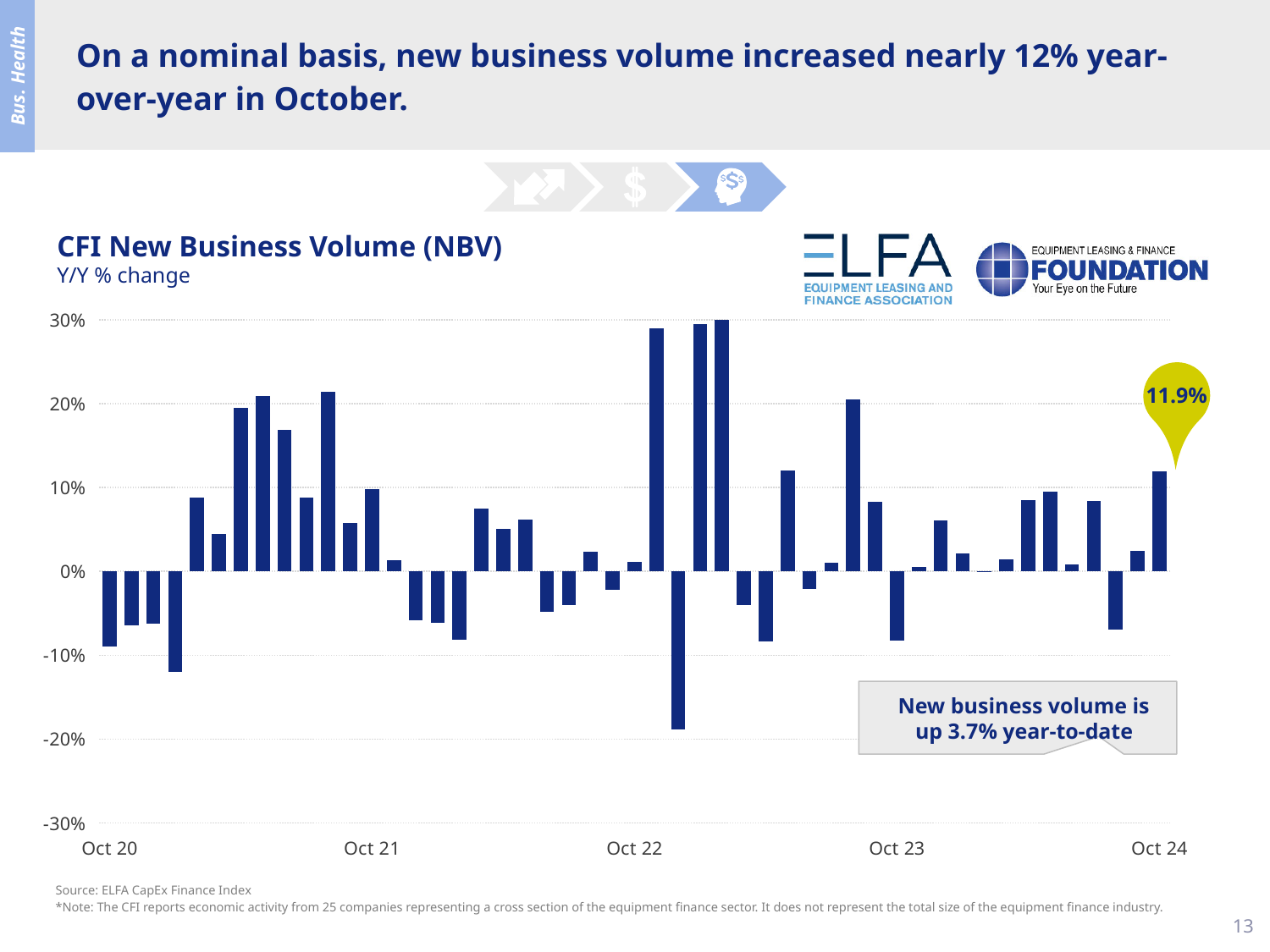
Is the highest value on the chart greater or less than 20%? greater How many labels are shown on the x axis of the chart? 5 Is the lowest value on the chart greater or less than -10%? less What kind of chart is shown on the slide? bar chart What is the Y/Y % change in CFI New Business Volume for Oct 24? 11.9% Is the value for Oct 20 greater or less than 0%? less What is the title of the chart? CFI New Business Volume (NBV) Which is larger, the value for Oct 20 or the value for Oct 24? Oct 24 What is the source cited for the chart? ELFA CapEx Finance Index